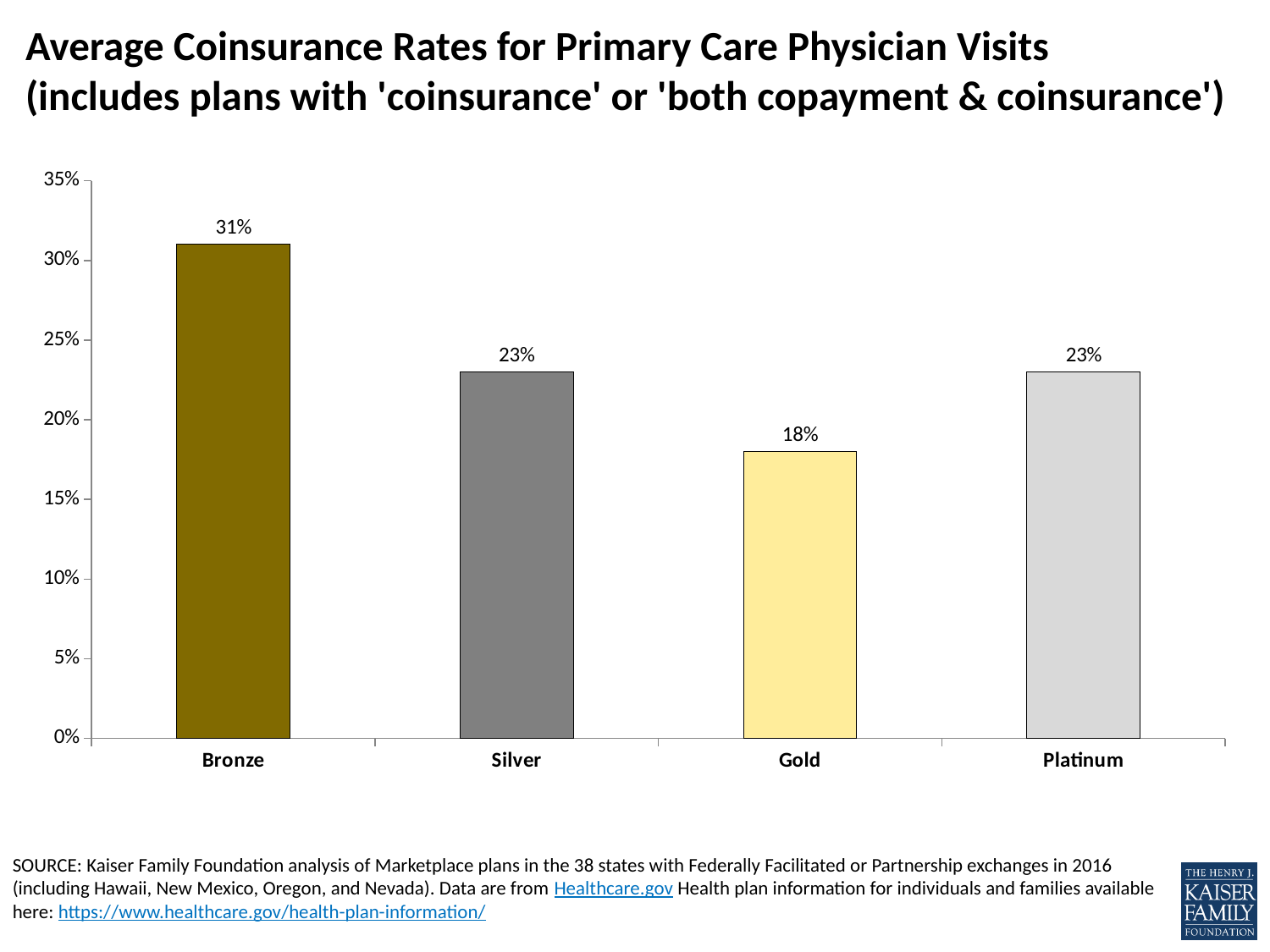
Which two plan tiers have the same average coinsurance rate? Silver and Platinum Which plan tier has the lowest average coinsurance rate? Gold What is the difference between the Silver and Gold average coinsurance rates? 5 percentage points Which plan tier has the highest average coinsurance rate? Bronze What is the average coinsurance rate for Silver plans? 23% How many plan tiers are shown on the chart? 4 What is the average coinsurance rate for Bronze plans? 31% What is the average coinsurance rate for Gold plans? 18% Which has a higher average coinsurance rate, Bronze or Platinum? Bronze Is the value for Gold greater or less than 20%? less What is the difference between the Bronze and Gold average coinsurance rates? 13 percentage points What kind of chart is shown on the slide? Bar chart